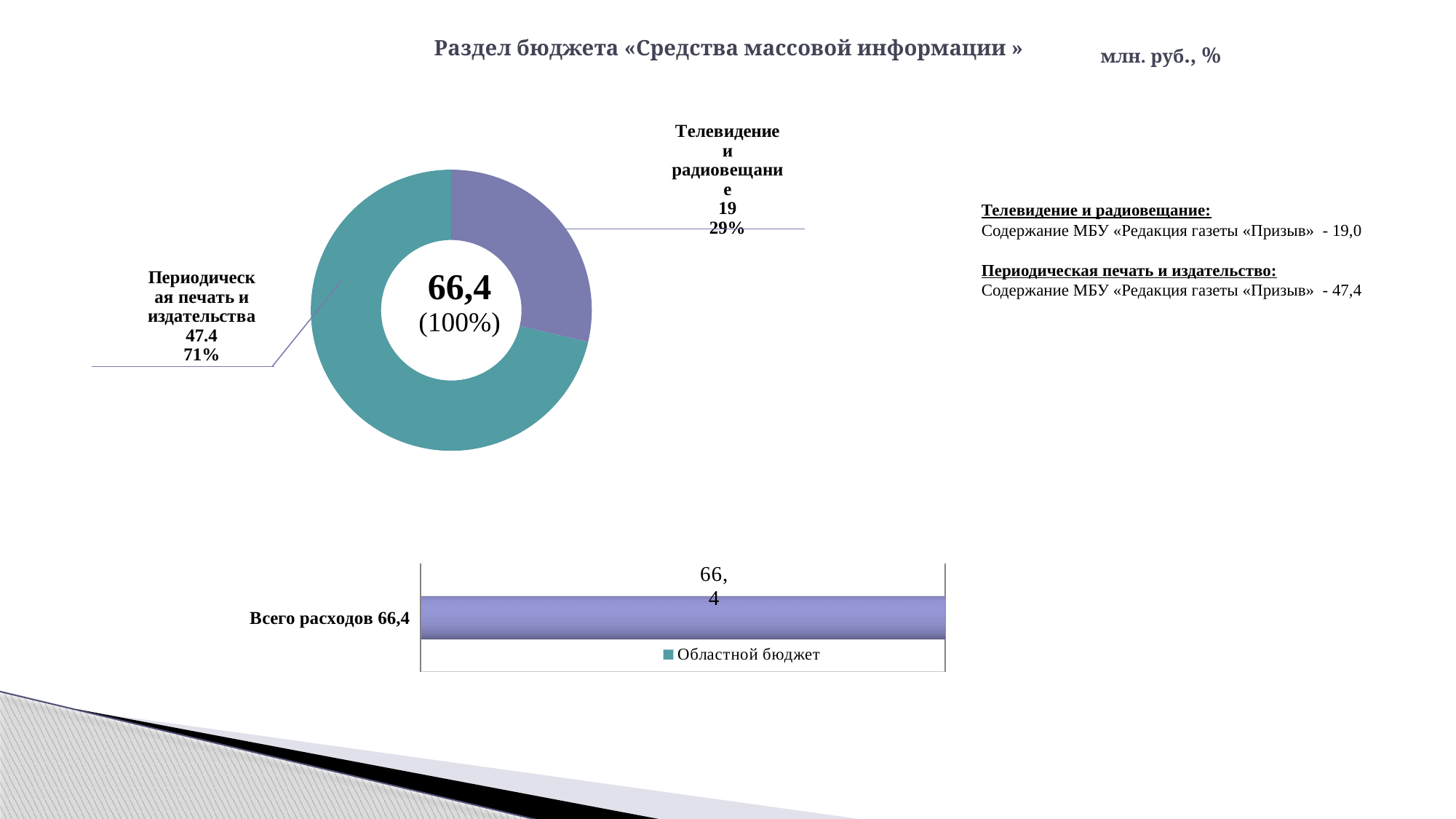
What kind of chart is the lower chart on the slide? bar chart In the donut chart, what total value is shown in the centre? 66,4 In the donut chart, which is larger: Телевидение и радиовещание or Периодическая печать и издательства? Периодическая печать и издательства In the donut chart, what share does Периодическая печать и издательства have? 71% In the donut chart, which category has the largest slice? Периодическая печать и издательства In the donut chart, how many slices are there? 2 In the donut chart, what is the value for Телевидение и радиовещание? 19 In the donut chart, what is the value for Периодическая печать и издательства? 47.4 In the lower bar chart, what is the value of the bar for Всего расходов? 66,4 In the lower bar chart, what series does the legend list? Областной бюджет In the donut chart, which category has the smallest slice? Телевидение и радиовещание In the donut chart, what share does Телевидение и радиовещание have? 29%